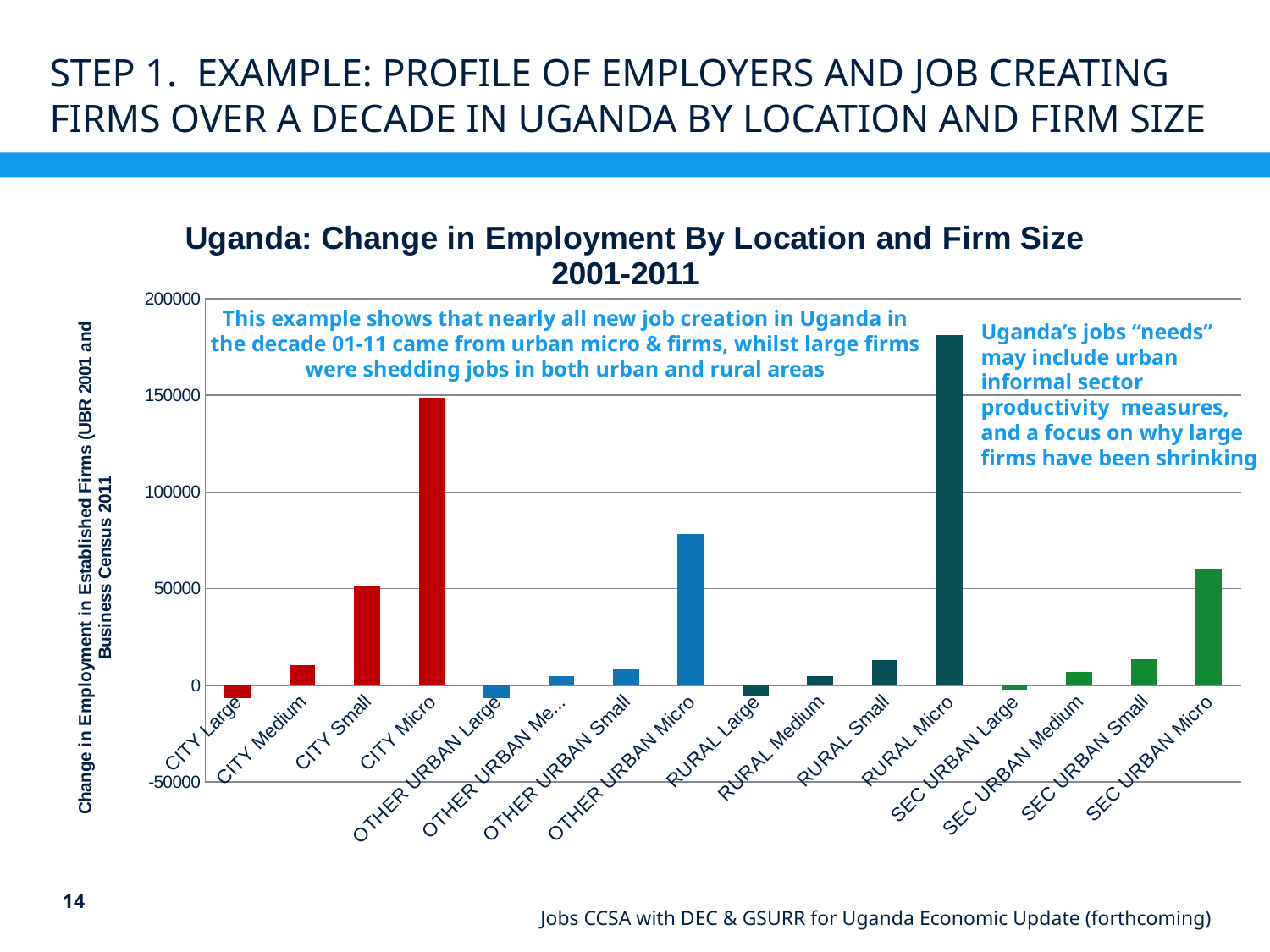
Which category has the highest change in employment? RURAL Micro What kind of chart is shown on the slide? bar chart What is the title of the chart? Uganda: Change in Employment By Location and Firm Size 2001-2011 Is the value for CITY Small greater or less than 100000? less What colour are the bars for the CITY categories? red Which is larger, the value for CITY Micro or the value for OTHER URBAN Micro? CITY Micro Is the value for RURAL Micro greater or less than 150000? greater Is the value for OTHER URBAN Micro greater or less than 50000? greater Which is larger, the value for RURAL Micro or the value for CITY Micro? RURAL Micro How many categories are plotted on the x axis of the chart? 16